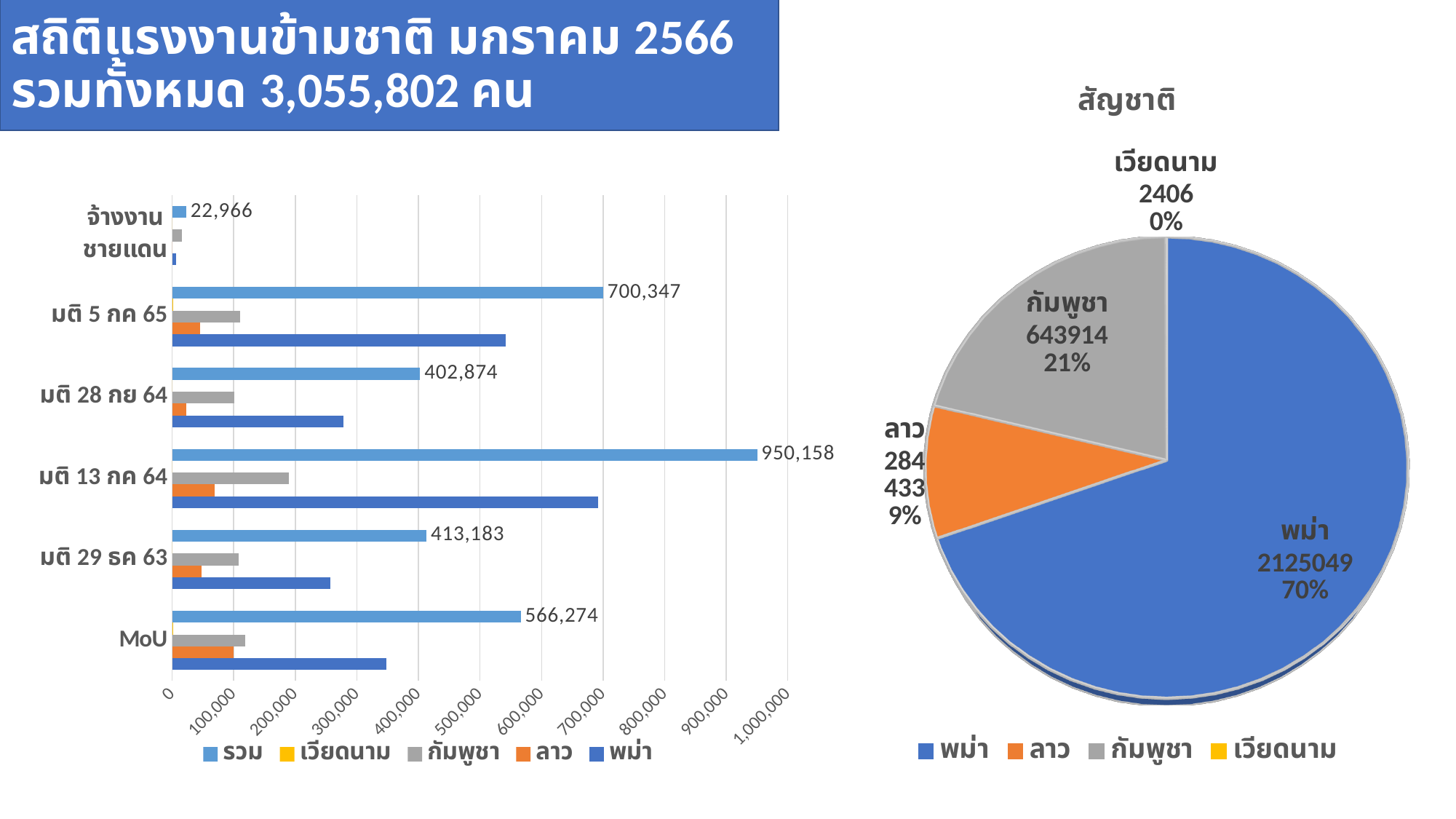
In the bar chart on the left, which has the larger รวม value, มติ 5 กค 65 or MoU? มติ 5 กค 65 How many series does the legend of the bar chart on the left list? 5 In the pie chart titled สัญชาติ, what value is shown for กัมพูชา? 643914 In the pie chart titled สัญชาติ, what share of the pie does ลาว have? 9% How many categories are shown on the bar chart on the left? 6 In the bar chart on the left, which category has the lowest รวม value? จ้างงานชายแดน In the bar chart on the left, what is the difference between the รวม values for มติ 13 กค 64 and มติ 5 กค 65? 249,811 What kind of chart is the chart on the left of the slide? bar chart In the bar chart on the left, what is the value of the รวม series for มติ 13 กค 64? 950,158 In the bar chart on the left, which category has the highest รวม value? มติ 13 กค 64 In the pie chart titled สัญชาติ, which slice is the largest? พม่า In the bar chart on the left, is the พม่า value for มติ 13 กค 64 greater or less than 600,000? greater